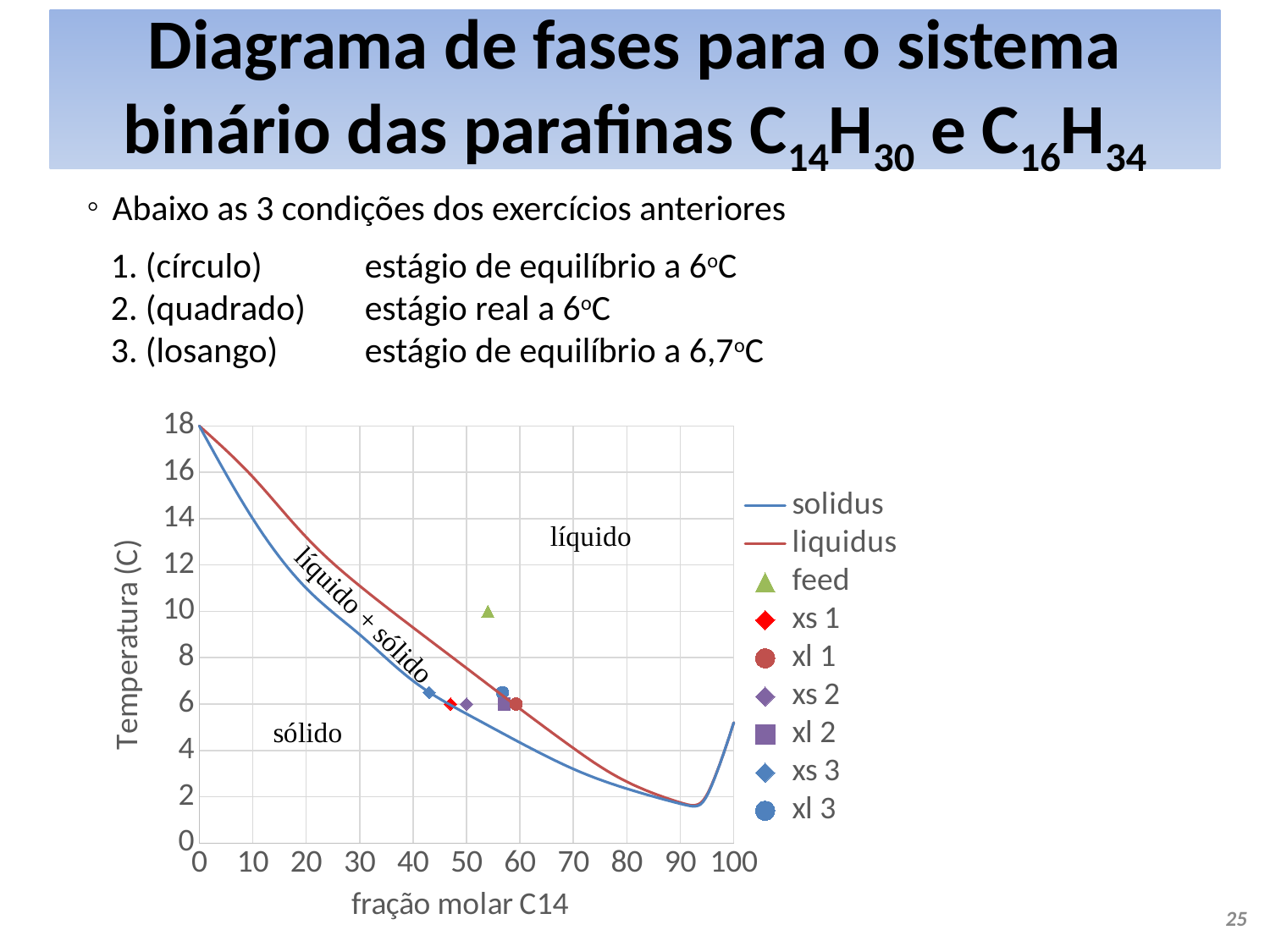
Is the fração molar C14 of the feed point greater or less than 50? greater Is the fração molar C14 of the xl 1 point greater or less than 50? greater Which point has the higher temperature, feed or xs 1? feed Which legend series is drawn as the red line? liquidus What is the highest value shown on the temperature axis? 18 What kind of chart is shown on the slide? scatter chart with lines Is the temperature of the feed point greater or less than 8? greater Does the liquidus curve rise or fall as fração molar C14 increases from 0 to 90? fall Which point has the larger fração molar C14, xl 1 or xs 3? xl 1 What is the title of the x axis of the chart? fração molar C14 How many series does the chart legend list? 9